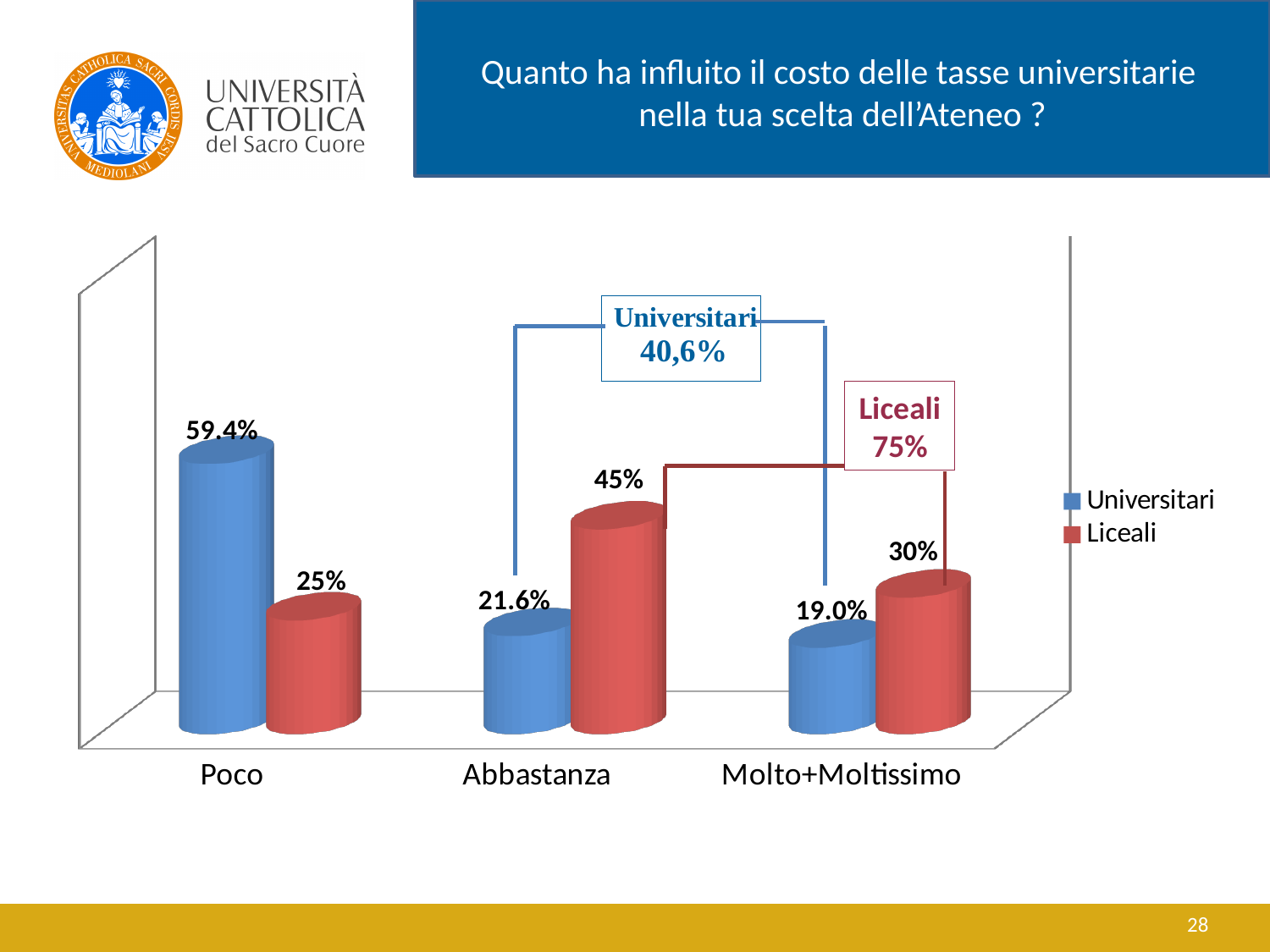
How many categories are shown on the x axis? 3 How many series does the legend list? 2 What is the value for Universitari in the Poco category? 59.4% What is the value for Universitari in the Molto+Moltissimo category? 19.0% Which category has the highest value for the Universitari series? Poco In the Molto+Moltissimo category, which series has the larger value, Universitari or Liceali? Liceali What is the value for Liceali in the Abbastanza category? 45% Which category has the lowest value for the Liceali series? Poco What is the difference between the Universitari and Liceali values in the Abbastanza category? 23.4% What combined percentage does the annotation box give for Liceali across Abbastanza and Molto+Moltissimo? 75% What is the value for Liceali in the Poco category? 25% What kind of chart is shown on the slide? Bar chart